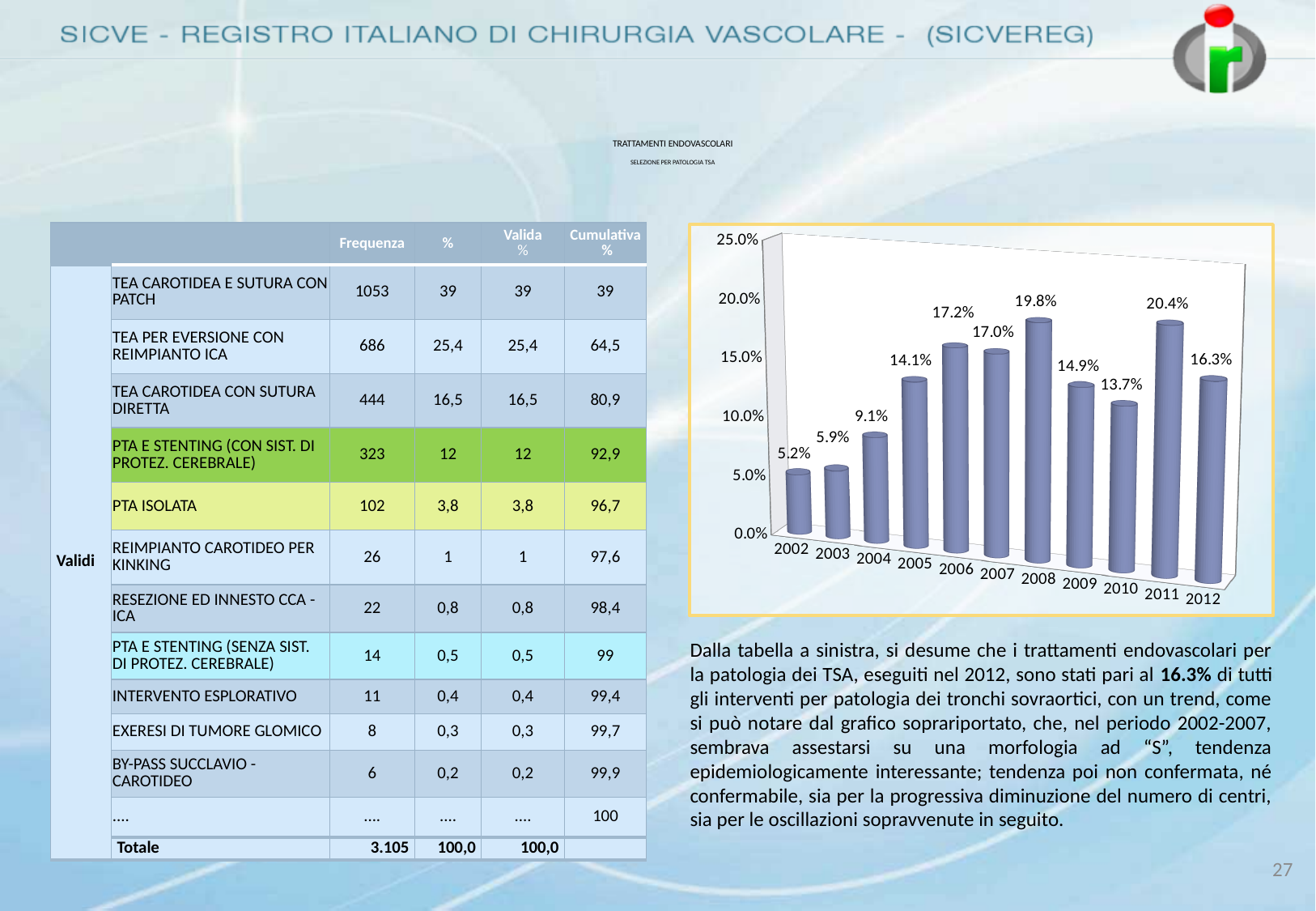
What is the difference between the values for 2011 and 2012? 4.1% What is the value for 2012? 16.3% What is the value for 2002? 5.2% Which is larger, the value for 2009 or the value for 2010? 2009 Which year has the highest value? 2011 Is the value for 2005 greater or less than 10.0%? greater Do the values rise or fall from 2002 to 2005? rise How many years are shown on the x axis? 11 What is the value for 2008? 19.8% What kind of chart is shown on the slide? bar chart Which year has the lowest value? 2002 What is the highest tick shown on the y axis? 25.0%